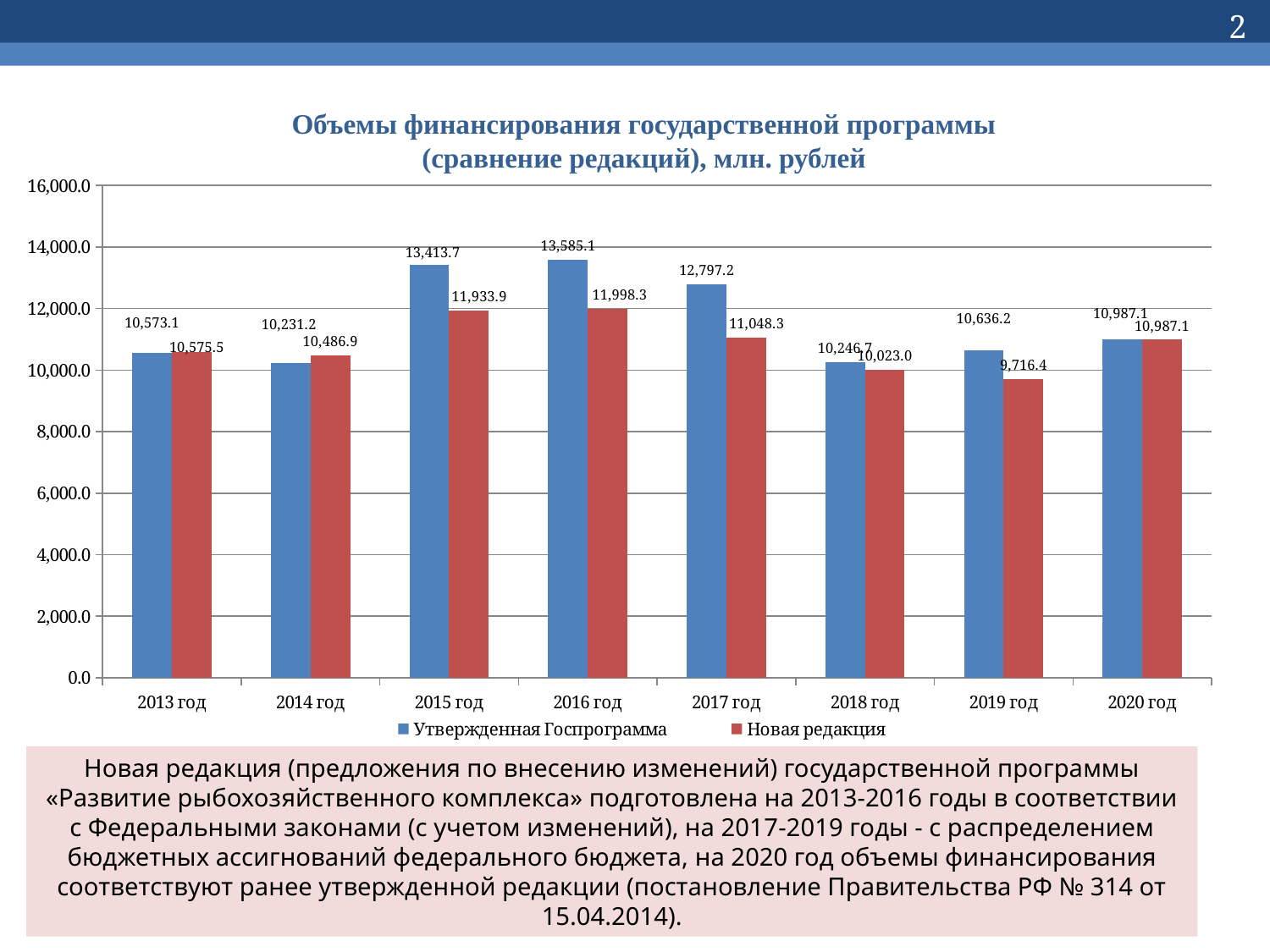
In which year is the Утвержденная Госпрограмма value highest? 2016 год What is the value for Утвержденная Госпрограмма in 2016 год? 13,585.1 What type of chart is shown on the slide? Bar chart Which colour represents the Новая редакция series? Red How many series does the legend list? 2 What is the difference between Утвержденная Госпрограмма and Новая редакция in 2015 год? 1,479.8 In which year is the Новая редакция value lowest? 2019 год What is the value for Новая редакция in 2019 год? 9,716.4 How many year categories are shown on the x axis? 8 Which is larger in 2017 год: Утвержденная Госпрограмма or Новая редакция? Утвержденная Госпрограмма What is the value for Новая редакция in 2015 год? 11,933.9 Is the value for Утвержденная Госпрограмма in 2018 год greater or less than 12,000.0? less